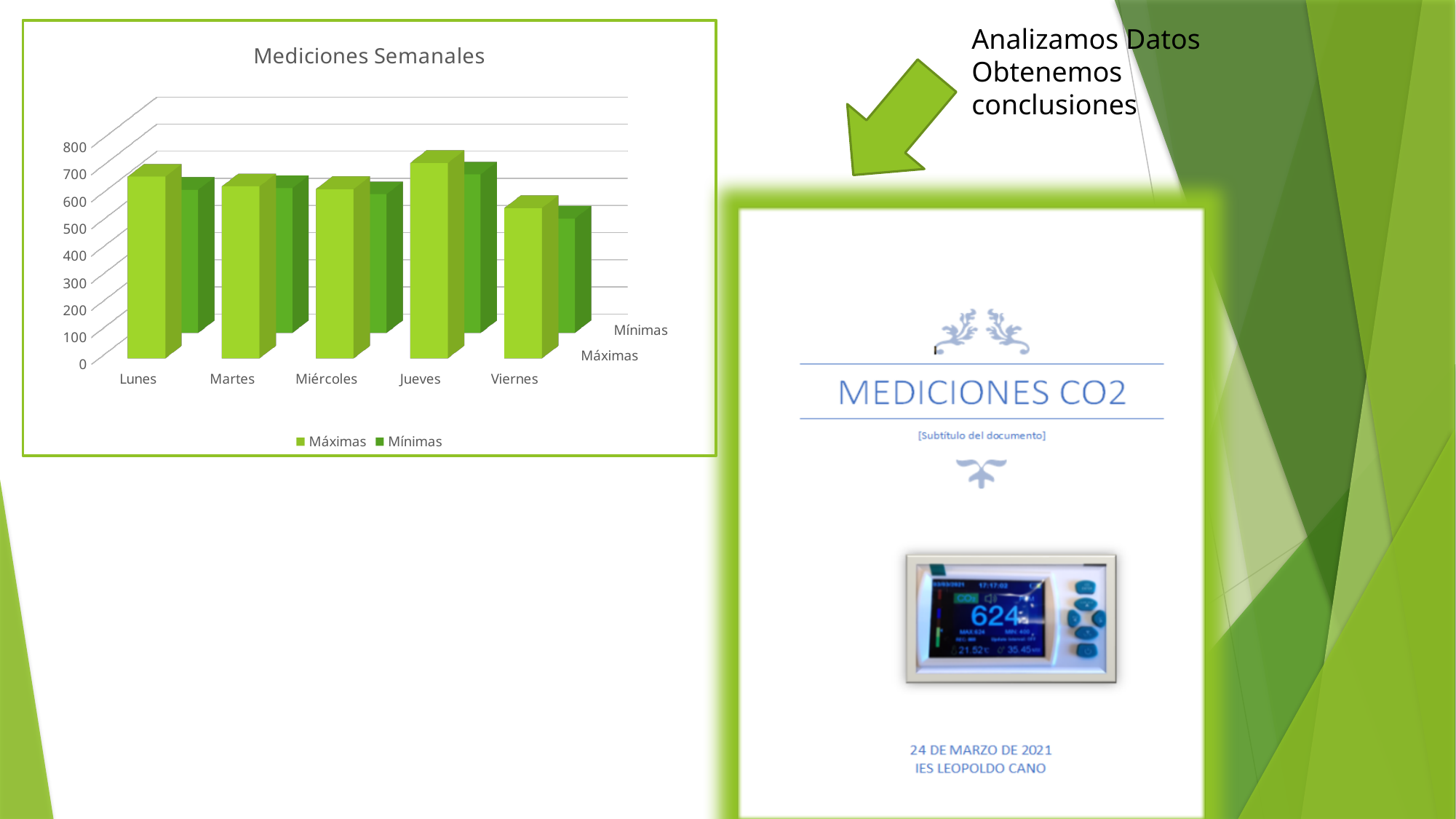
Is the Máximas value for Viernes greater or less than 800? less How many series does the chart's legend list? 2 Which series are listed in the chart's legend? Máximas and Mínimas Which is larger, the Máximas value for Jueves or the Máximas value for Viernes? Jueves Which day has the highest Máximas value in the chart? Jueves Which day has the lowest Máximas value in the chart? Viernes Which day has the highest Mínimas value in the chart? Jueves Is the Máximas value for Jueves greater or less than 600? greater Which day has the lowest Mínimas value in the chart? Viernes What is the title of the chart on the slide? Mediciones Semanales What kind of chart is shown on the slide? bar chart How many categories (days) are shown on the x axis of the chart? 5